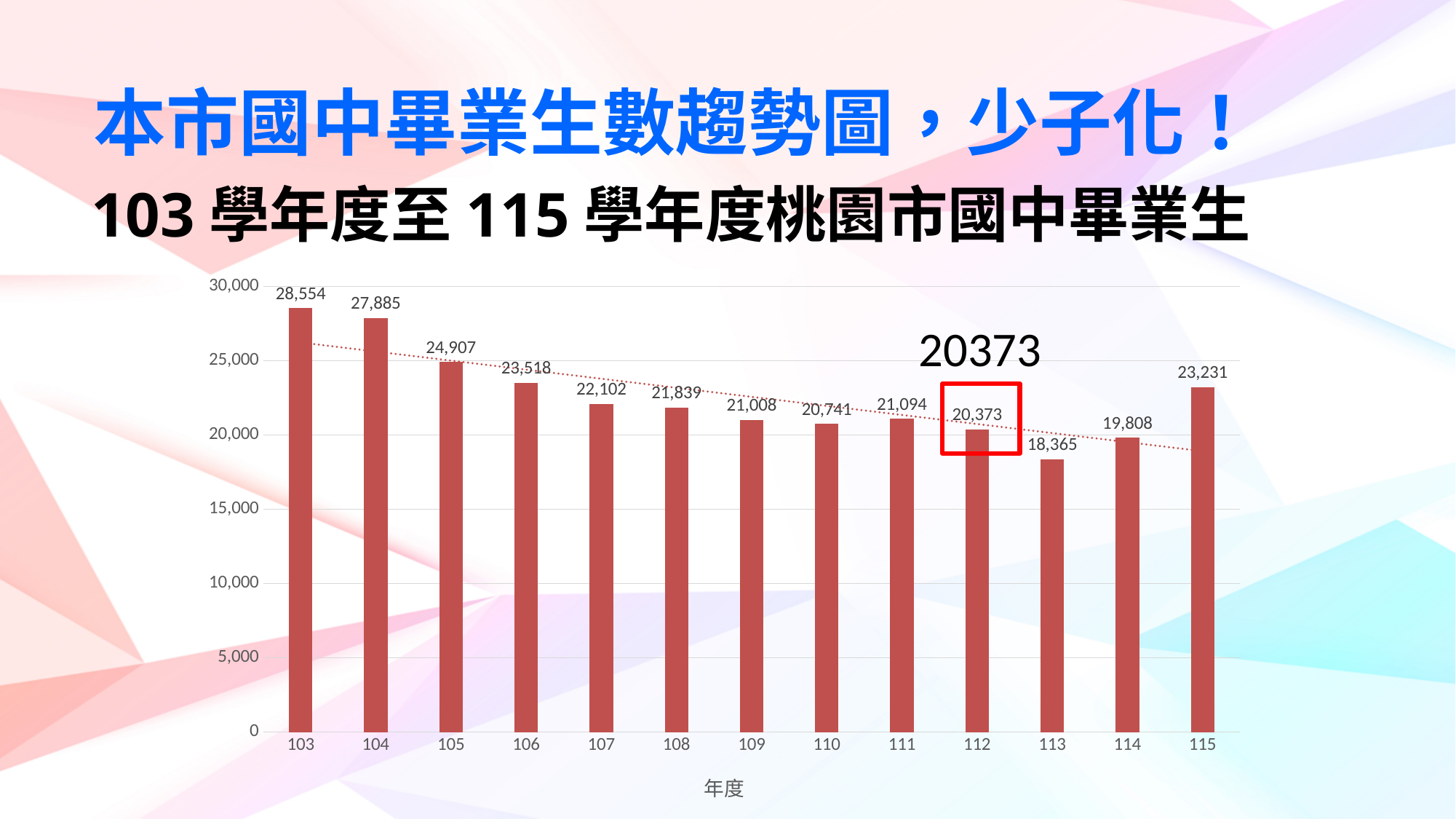
How many years are shown on the x axis? 13 What is the value for year 103? 28,554 Which year has the lowest value? 113 What is the difference between the values for year 103 and year 104? 669 Which year has the highest value? 103 What kind of chart is shown on the slide? bar chart What is the label of the x axis? 年度 What is the value for year 112? 20,373 Which is larger, the value for year 110 or the value for year 111? 111 What is the difference between the values for year 115 and year 114? 3,423 What is the value for year 115? 23,231 Is the value for year 113 greater or less than 20,000? less